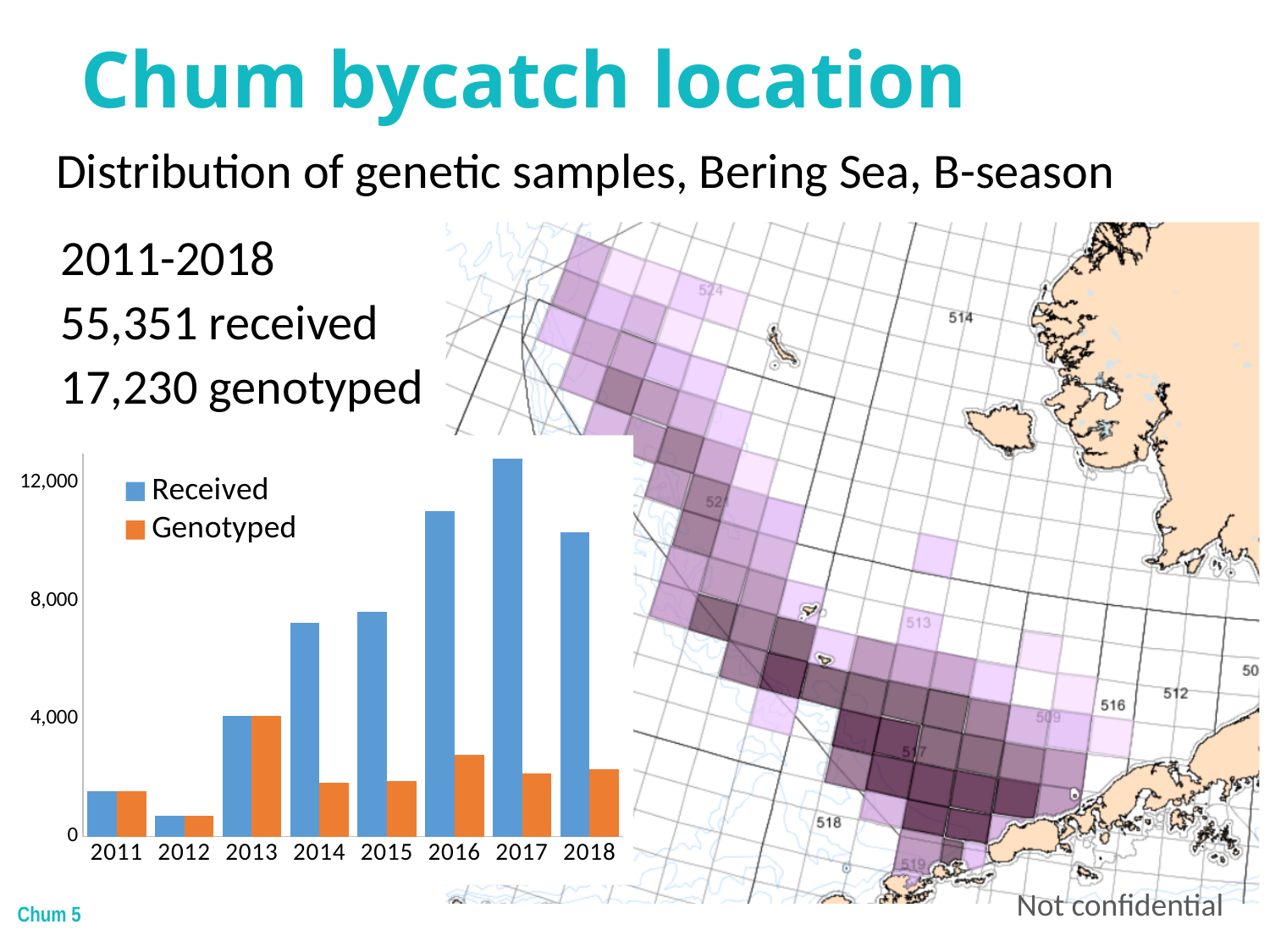
Is the Received value for 2016 greater or less than 8,000? greater Do the Received values rise or fall from 2012 to 2017? rise Is the Received value for 2017 greater or less than 12,000? greater Which year has the highest Received value? 2017 Is the Genotyped value for 2014 greater or less than 4,000? less Which colour represents the Genotyped series in the chart? orange Which year has the lowest Received value? 2012 Which year has the highest Genotyped value? 2013 What kind of chart is shown on the slide? bar chart How many years are shown on the x axis of the chart? 8 How many series does the chart's legend list? 2 Which year has the larger Received value, 2016 or 2018? 2016